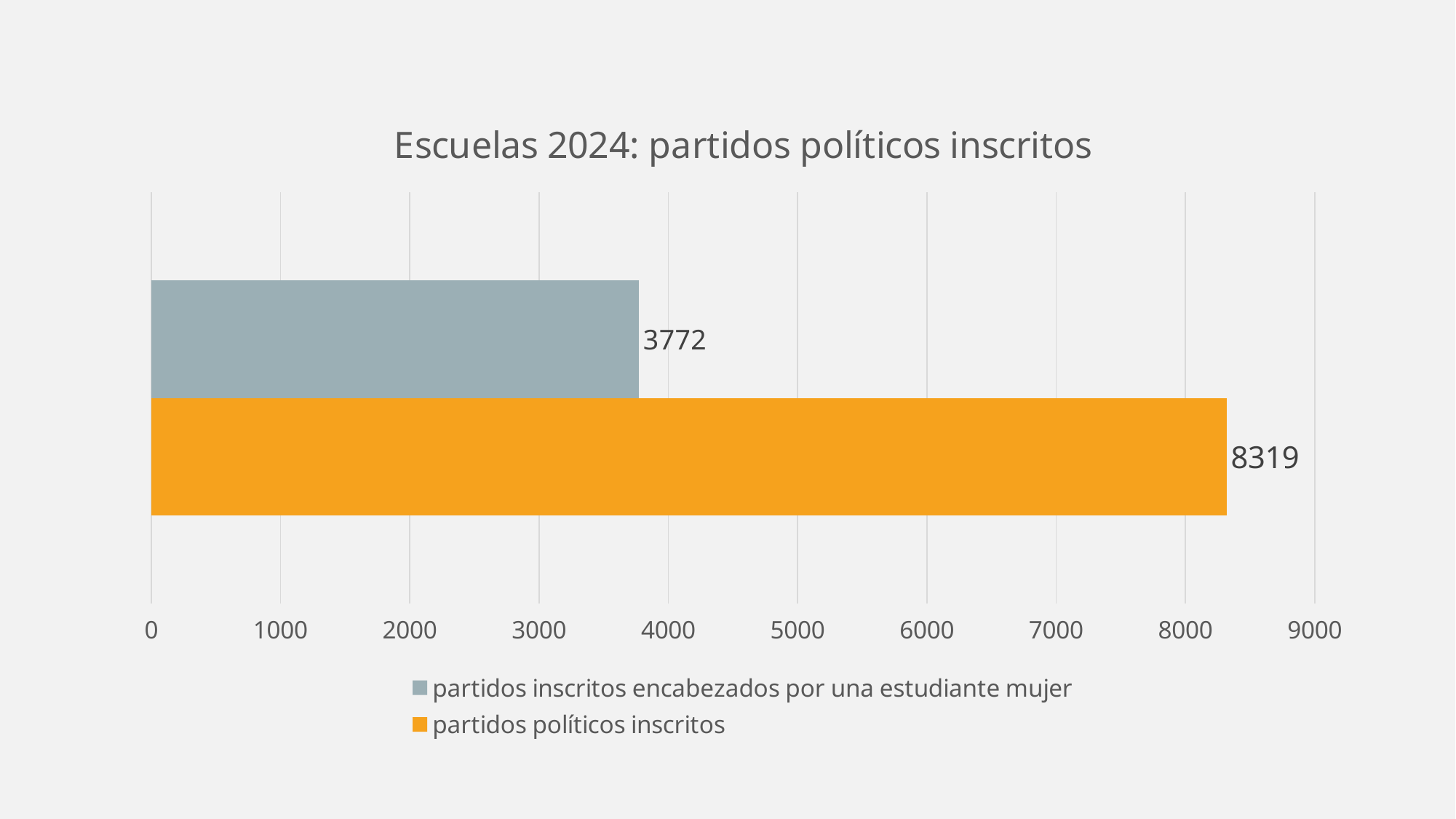
Is the value for 'partidos políticos inscritos' greater or less than 8000? greater Which series has the lower value? partidos inscritos encabezados por una estudiante mujer What kind of chart is shown on the slide? Bar chart What is the value for 'partidos políticos inscritos'? 8319 Is the value for 'partidos políticos inscritos' larger than the value for 'partidos inscritos encabezados por una estudiante mujer'? Yes How many bars are plotted on the chart? 2 What is the value for 'partidos inscritos encabezados por una estudiante mujer'? 3772 What is the difference between 'partidos políticos inscritos' and 'partidos inscritos encabezados por una estudiante mujer'? 4547 What is the title of the chart? Escuelas 2024: partidos políticos inscritos How many series does the legend list? 2 Which series has the higher value? partidos políticos inscritos Is the value for 'partidos inscritos encabezados por una estudiante mujer' greater or less than 4000? less